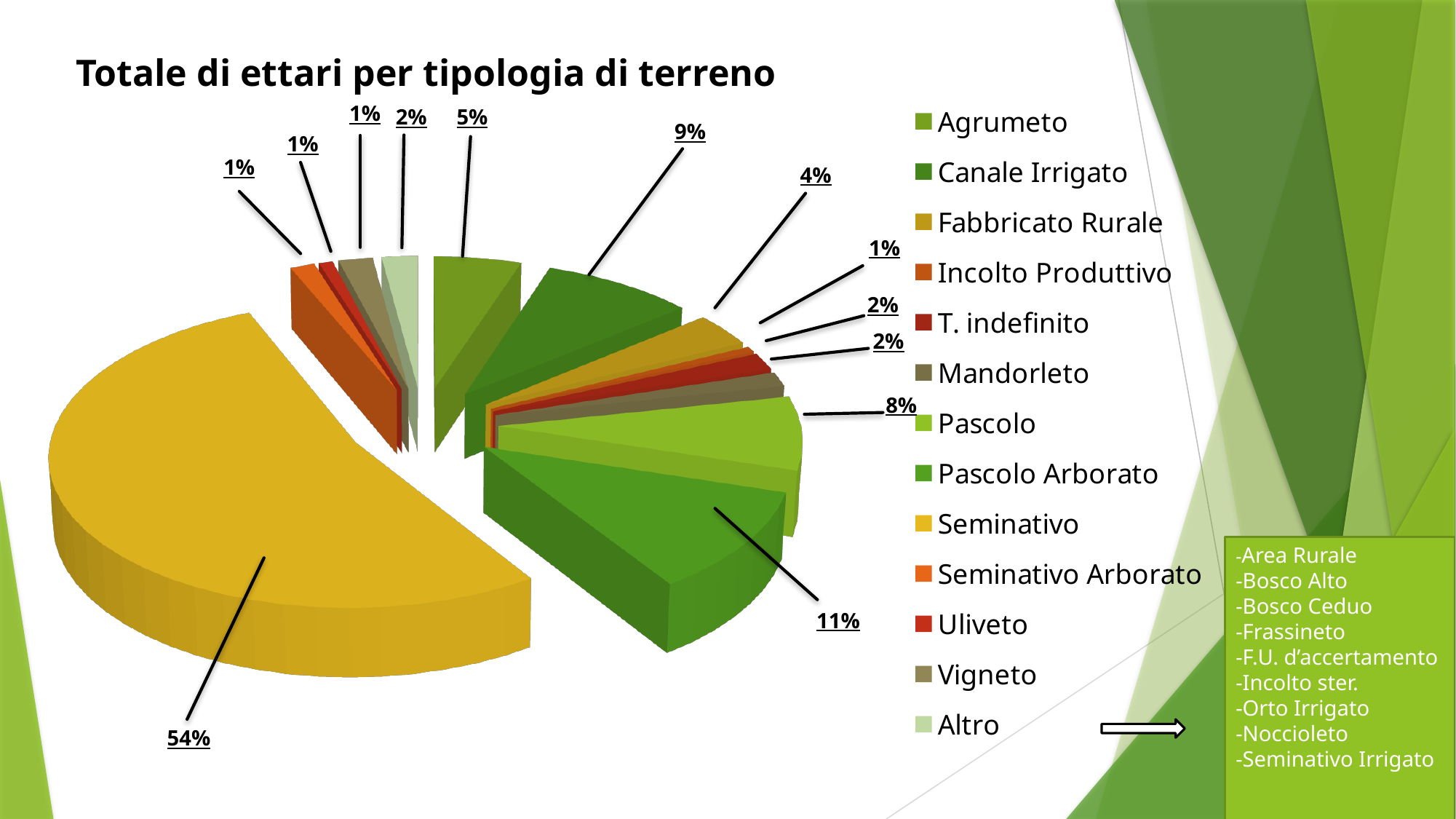
What share of the pie does Seminativo represent? 54% What share of the pie does Fabbricato Rurale represent? 4% What share of the pie does Agrumeto represent? 5% Which category has the largest slice of the pie? Seminativo What is the difference in percentage points between the Seminativo share and the Pascolo Arborato share? 43 How many categories does the legend of the pie chart list? 13 Which is larger, the share for Pascolo Arborato or the share for Canale Irrigato? Pascolo Arborato What kind of chart is shown on the slide? Pie chart What is the title of the chart? Totale di ettari per tipologia di terreno